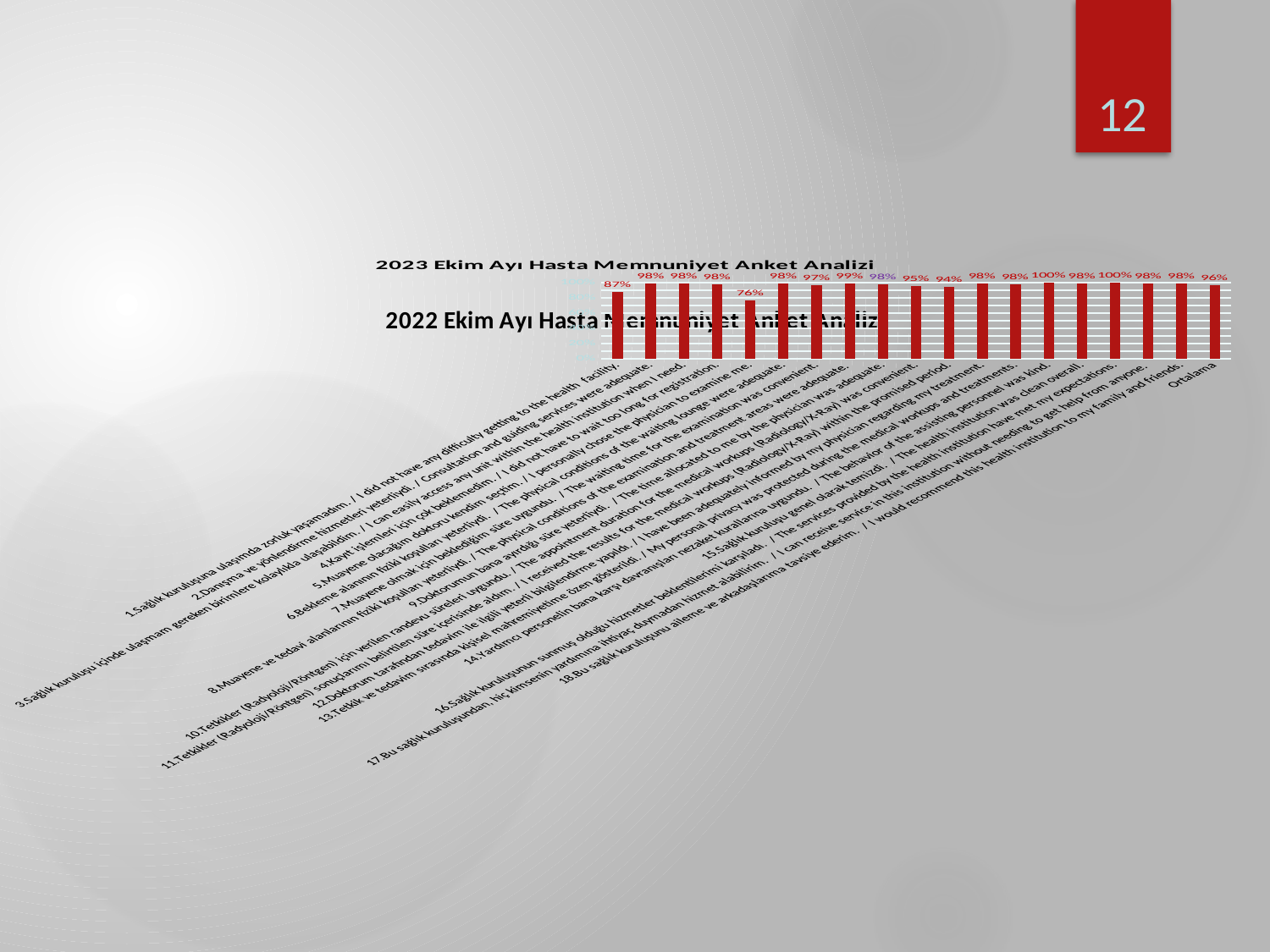
What is the difference between the highest value and the lowest value on the chart? 24 percentage points Which category has the lowest value on the chart? 5.Muayene olacağım doktoru kendim seçtim Which is larger, the value for the first category '1.Sağlık kuruluşuna ulaşımda zorluk yaşamadım' or the value for 'Ortalama'? Ortalama What is the value shown for the first category, '1.Sağlık kuruluşuna ulaşımda zorluk yaşamadım'? 87% What is the value shown for 'Ortalama'? 96% What is the highest value shown on the chart? 100% What is the difference between the 'Ortalama' value and the value for the first category '1.Sağlık kuruluşuna ulaşımda zorluk yaşamadım'? 9 percentage points What is the lowest value shown on the chart? 76% What is the title of the chart? 2023 Ekim Ayı Hasta Memnuniyet Anket Analizi What colour are the bars in the chart? red How many categories (bars) does the chart show? 19 What kind of chart is shown on the slide? bar chart